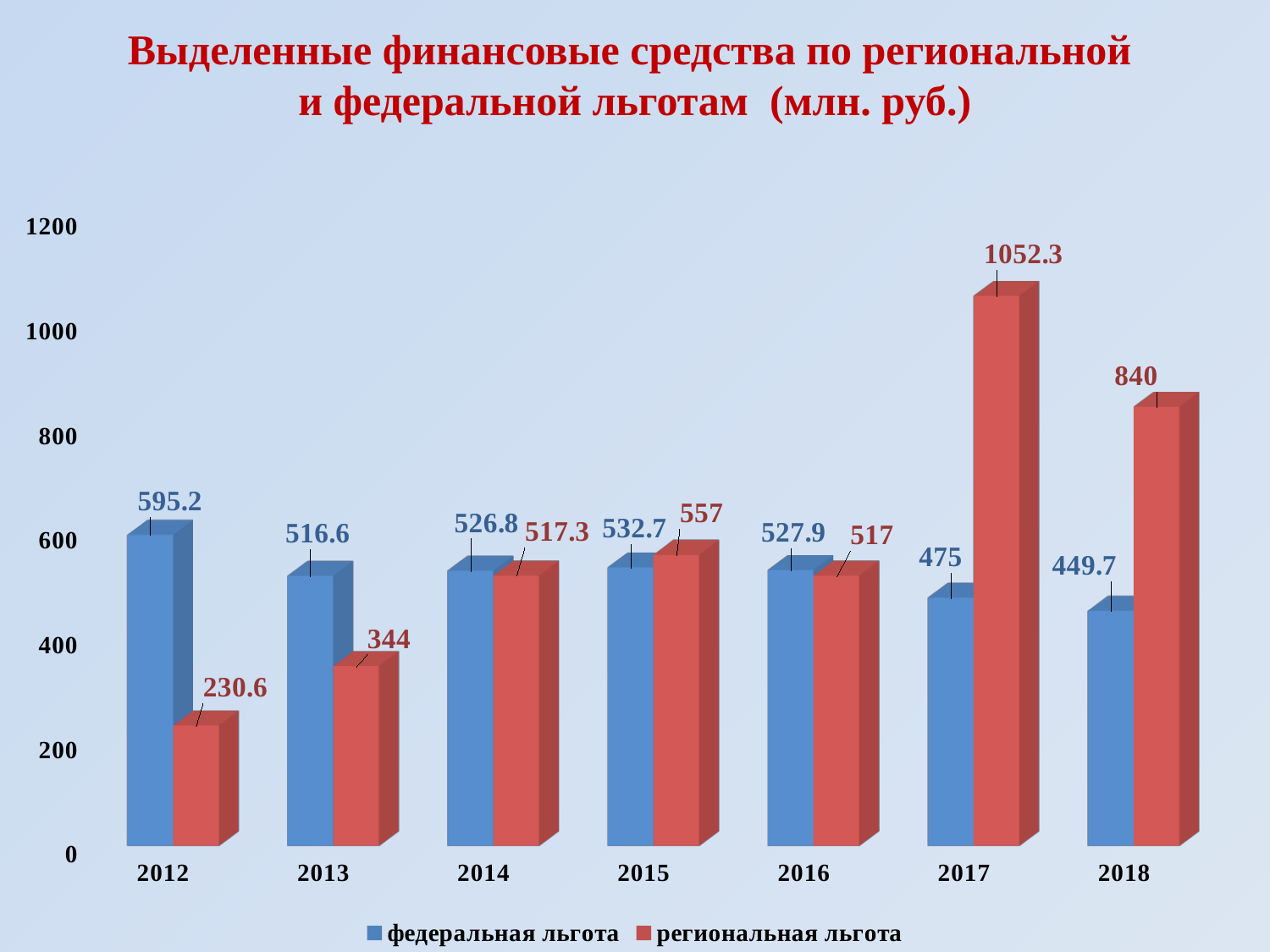
What is the value for федеральная льгота in 2012? 595.2 Which is larger in 2013: федеральная льгота or региональная льгота? федеральная льгота In which year is федеральная льгота the lowest? 2018 What kind of chart is shown on the slide? bar chart In which year is региональная льгота the highest? 2017 How many years are shown on the x axis? 7 What is the value for федеральная льгота in 2018? 449.7 In which year is региональная льгота the lowest? 2012 What is the difference between региональная льгота and федеральная льгота in 2018? 390.3 How many series does the legend list? 2 What is the value for региональная льгота in 2013? 344 What is the value for региональная льгота in 2017? 1052.3